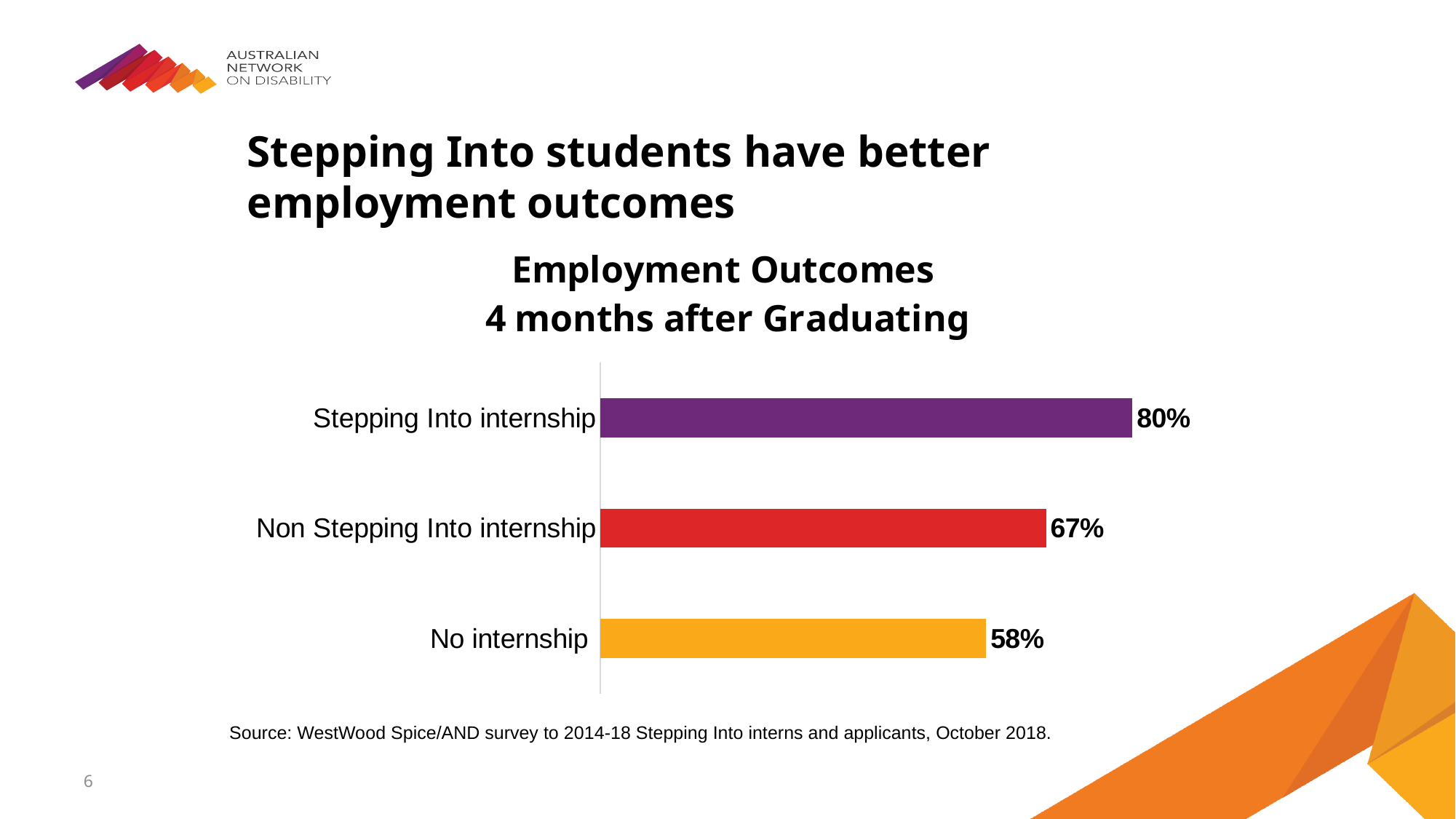
What kind of chart is shown on the slide? Bar chart Which category has the highest employment outcome? Stepping Into internship How many categories are shown in the chart? 3 Which is larger, the value for Non Stepping Into internship or No internship? Non Stepping Into internship What is the difference between the Stepping Into internship and Non Stepping Into internship values? 13% What is the difference between the Stepping Into internship and No internship values? 22% What is the employment outcome value for Stepping Into internship? 80% Which category has the lowest employment outcome? No internship What is the employment outcome value for No internship? 58% What is the title of the chart? Employment Outcomes 4 months after Graduating What is the employment outcome value for Non Stepping Into internship? 67% What colour is the bar for Stepping Into internship? Purple